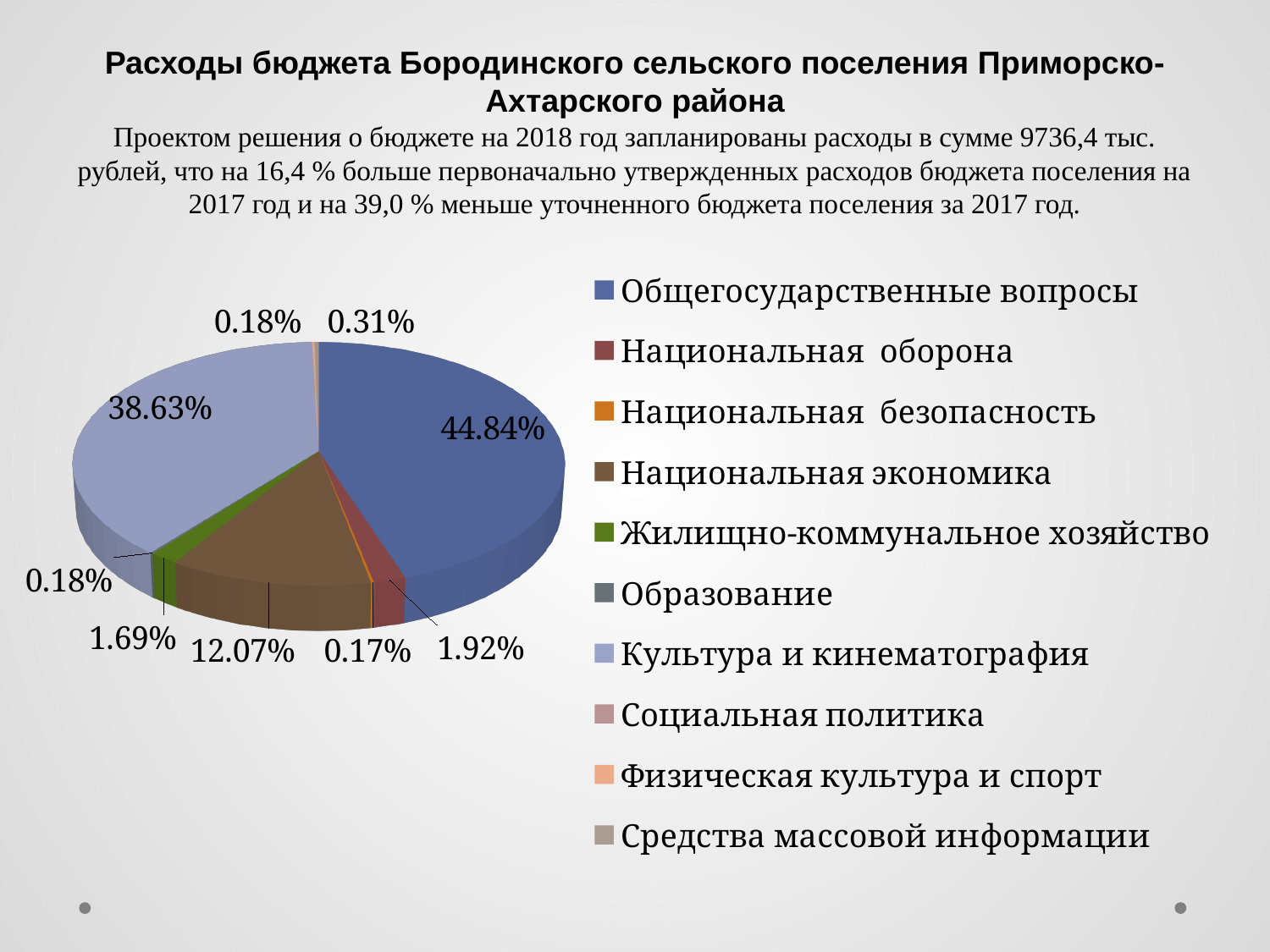
What type of chart is shown on the slide? Pie chart How many categories are listed in the legend? 10 What share of the budget expenditures is for Национальная оборона? 1.92% Which is larger: the share for Общегосударственные вопросы or for Культура и кинематография? Общегосударственные вопросы What share of the budget expenditures is for Культура и кинематография? 38.63% What colour is the slice for Национальная экономика? Brown What is the difference in percentage points between the shares for Общегосударственные вопросы and Культура и кинематография? 6.21% What share of the budget expenditures is for Общегосударственные вопросы? 44.84% Which category has the largest share of the pie? Общегосударственные вопросы What share of the budget expenditures is for Жилищно-коммунальное хозяйство? 1.69% What share of the budget expenditures is for Национальная экономика? 12.07% What share of the budget expenditures is for Физическая культура и спорт? 0.18%